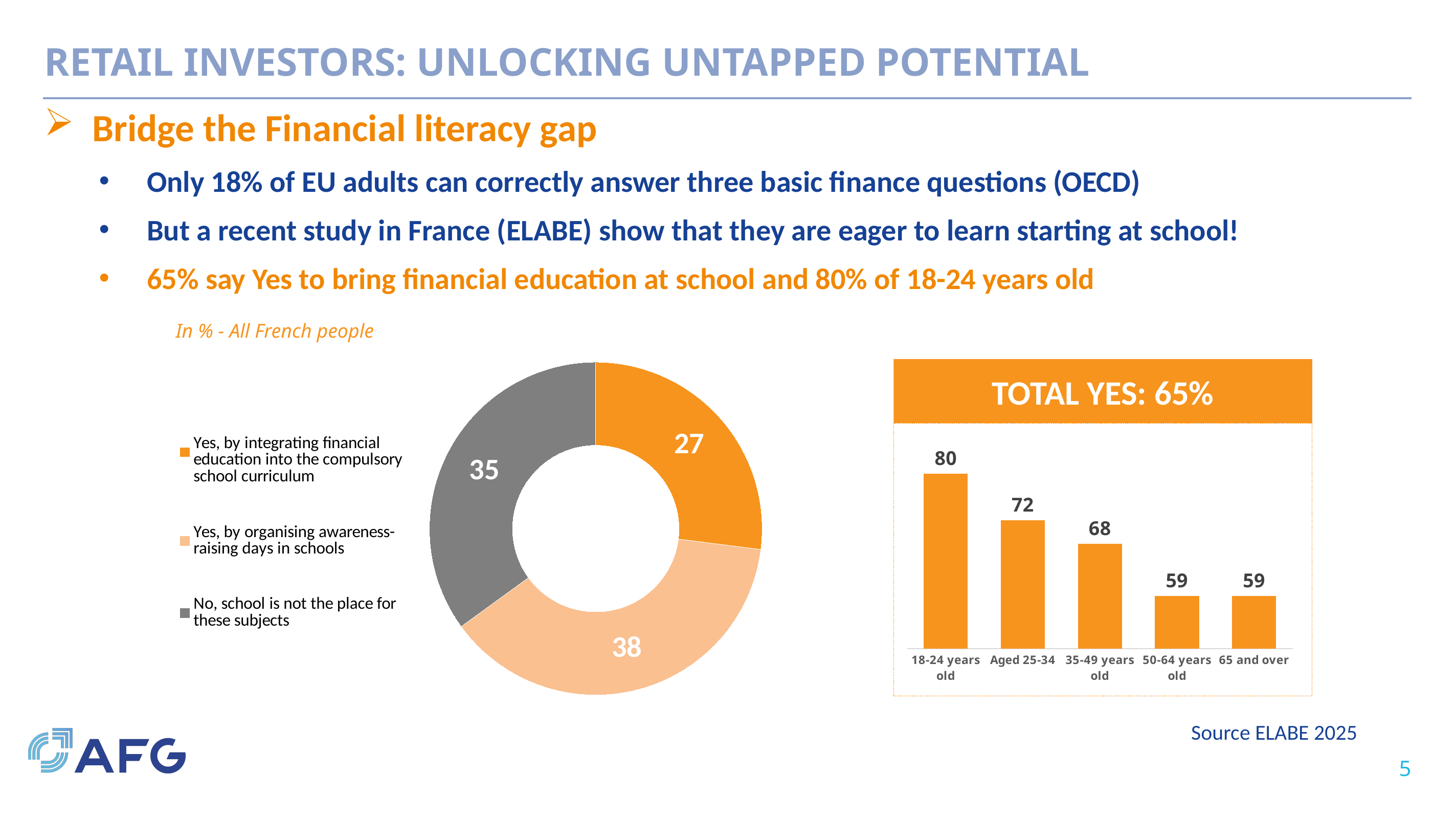
In the doughnut chart on the left, what value is shown for 'Yes, by organising awareness-raising days in schools'? 38 In the doughnut chart on the left, what value is shown for 'No, school is not the place for these subjects'? 35 In the 'TOTAL YES: 65%' bar chart on the right, what is the difference between the values for 18-24 years old and 65 and over? 21 In the doughnut chart on the left, which category has the largest value? Yes, by organising awareness-raising days in schools In the 'TOTAL YES: 65%' bar chart on the right, what is the value for 18-24 years old? 80 In the 'TOTAL YES: 65%' bar chart on the right, what is the value for Aged 25-34? 72 In the doughnut chart on the left, what is the difference between the 'No, school is not the place for these subjects' value and the 'Yes, by integrating financial education into the compulsory school curriculum' value? 8 In the doughnut chart on the left, what value is shown for 'Yes, by integrating financial education into the compulsory school curriculum'? 27 In the 'TOTAL YES: 65%' bar chart on the right, how many age groups are shown? 5 In the doughnut chart on the left, how many categories does the legend list? 3 In the 'TOTAL YES: 65%' bar chart on the right, which age group has the highest value? 18-24 years old In the 'TOTAL YES: 65%' bar chart on the right, do the values rise or fall from the youngest to the oldest age group? fall